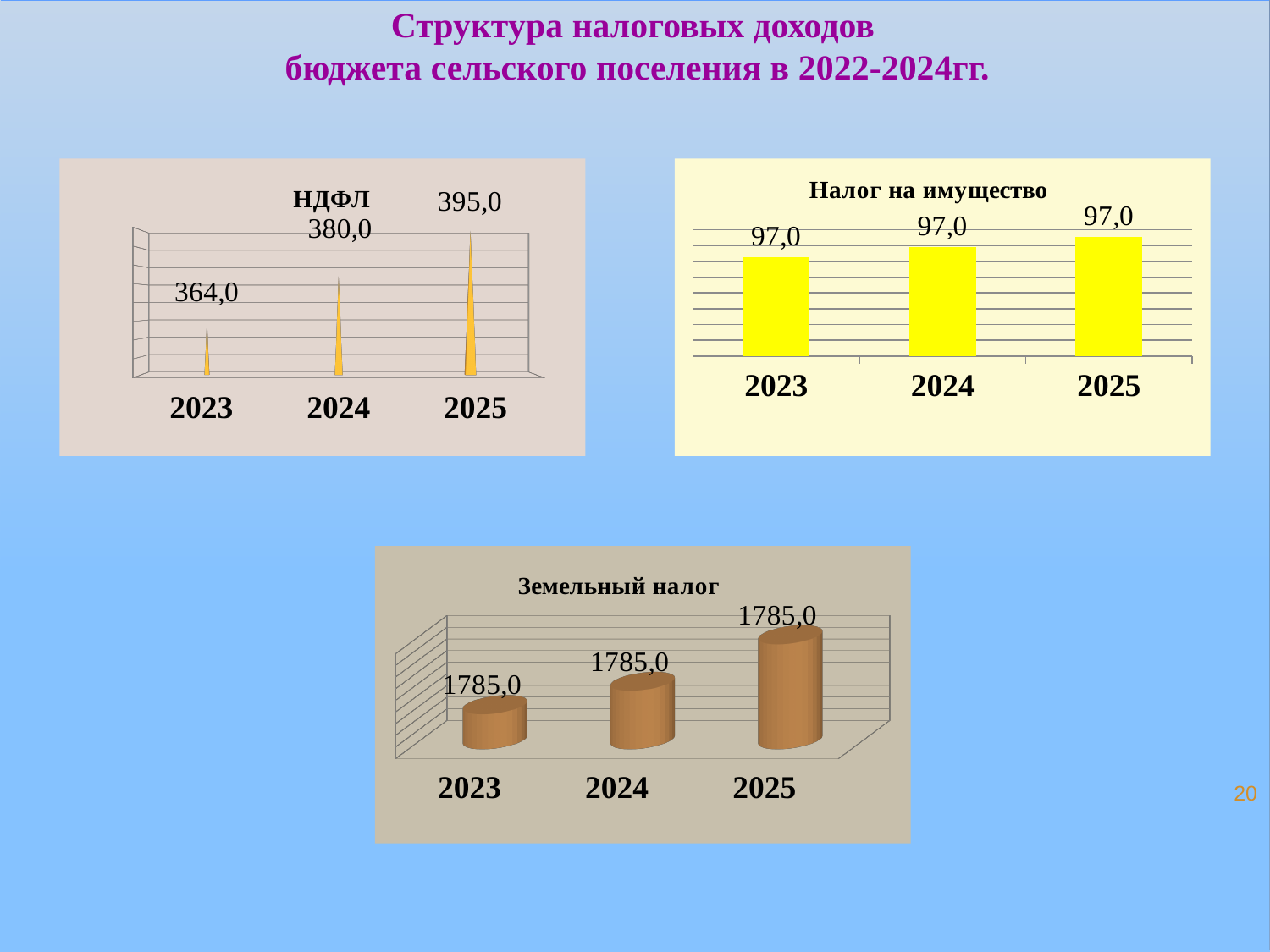
In the Земельный налог chart, what is the value for 2023? 1785,0 In the НДФЛ chart, which year has the highest value? 2025 In the Налог на имущество chart, what is the value for 2024? 97,0 In the НДФЛ chart, which year has the lowest value? 2023 In the НДФЛ chart, what is the value for 2025? 395,0 In the НДФЛ chart, do the values rise or fall from 2023 to 2025? rise What kind of chart is the Налог на имущество chart? bar chart What colour are the bars in the Налог на имущество chart? yellow In the НДФЛ chart, what is the value for 2023? 364,0 In the НДФЛ chart, what is the difference between the 2025 and 2023 values? 31,0 How many years are shown in the Налог на имущество chart? 3 In the Земельный налог chart, what is the value for 2025? 1785,0